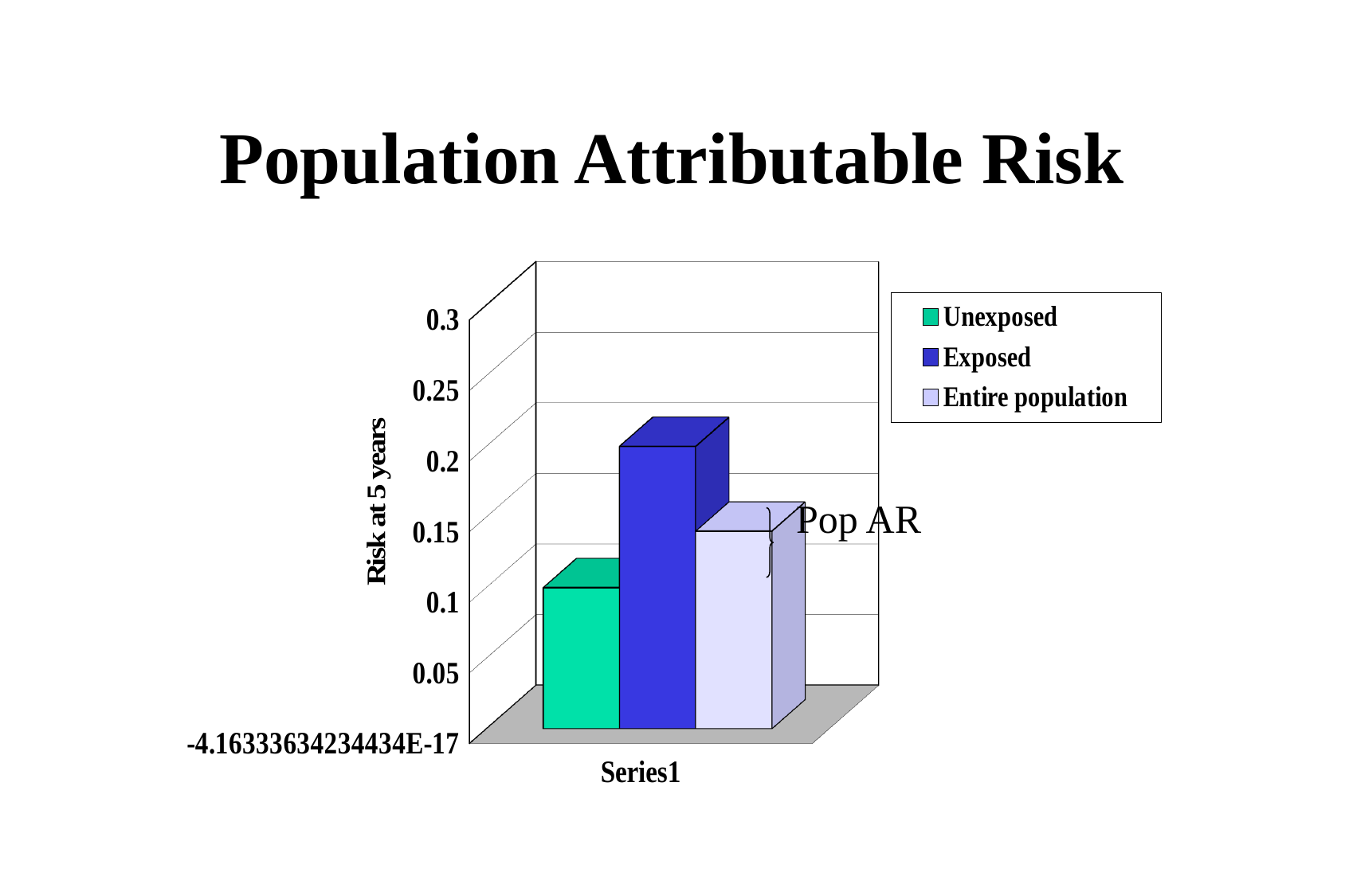
How many series does the legend list? 3 Which is larger, the value for Exposed or the value for Entire population? Exposed Which series has the lowest bar? Unexposed Is the value for Entire population greater or less than 0.1? greater Is the value for Exposed greater or less than 0.15? greater What kind of chart is shown on the slide? bar chart What label is written next to the bracket beside the Entire population bar? Pop AR What is the title of the vertical axis? Risk at 5 years Is the value for Unexposed greater or less than 0.15? less Which is larger, the value for Unexposed or the value for Entire population? Entire population Which series has the highest bar? Exposed